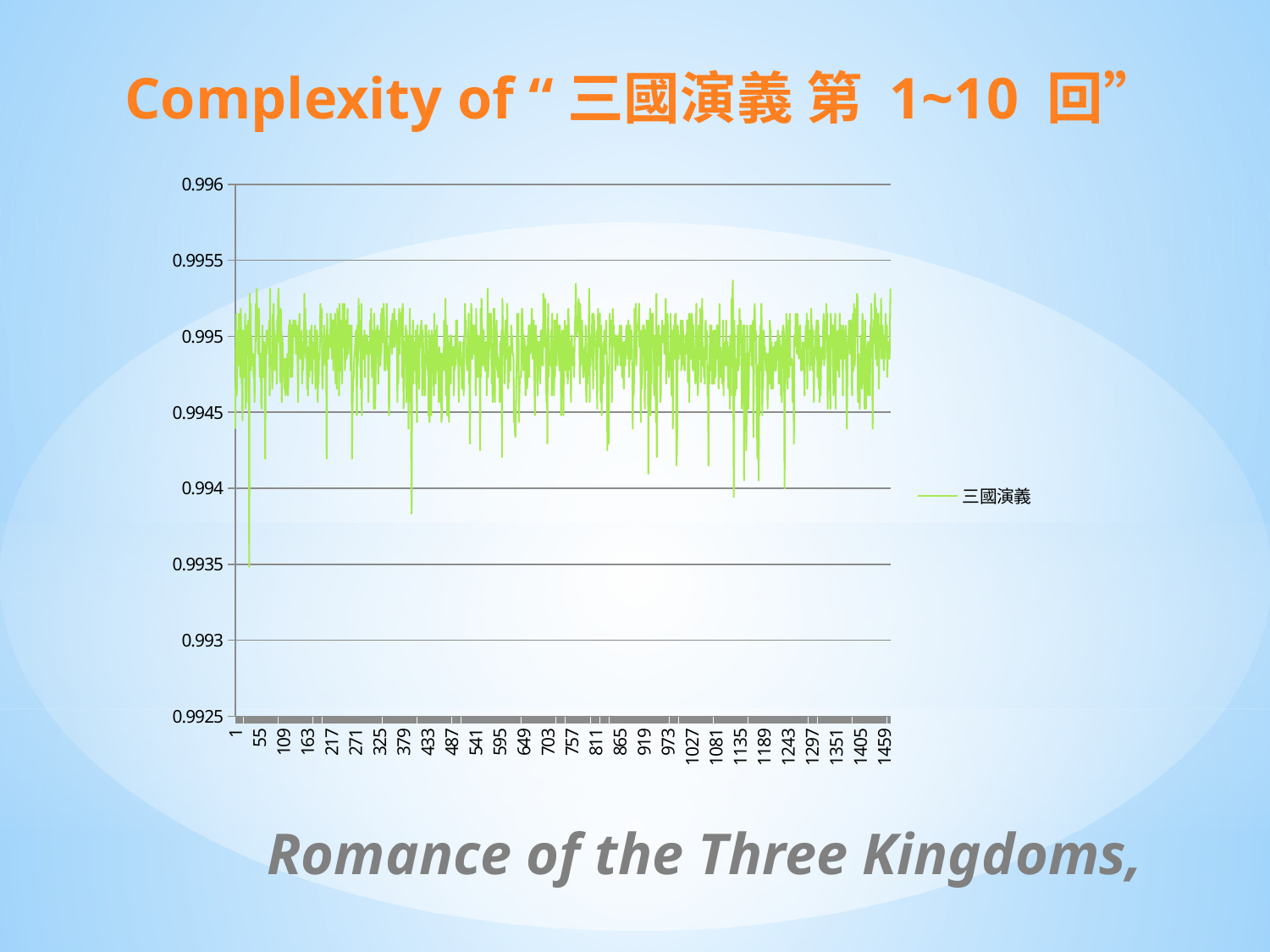
Are most of the plotted values greater or less than 0.9945? greater What is the last label shown on the x axis? 1459 Does the series show a clear rising trend, a clear falling trend, or stay roughly flat along the x axis? roughly flat What is the lowest value labelled on the y axis? 0.9925 What kind of chart is shown on the slide? line chart What is the first label shown on the x axis? 1 What is the highest value labelled on the y axis? 0.996 Is the lowest point of the series greater or less than 0.994? less What is the name of the series shown in the legend? 三國演義 What colour is the plotted line? green How many series does the legend list? 1 Is the highest point of the series greater or less than 0.9955? less